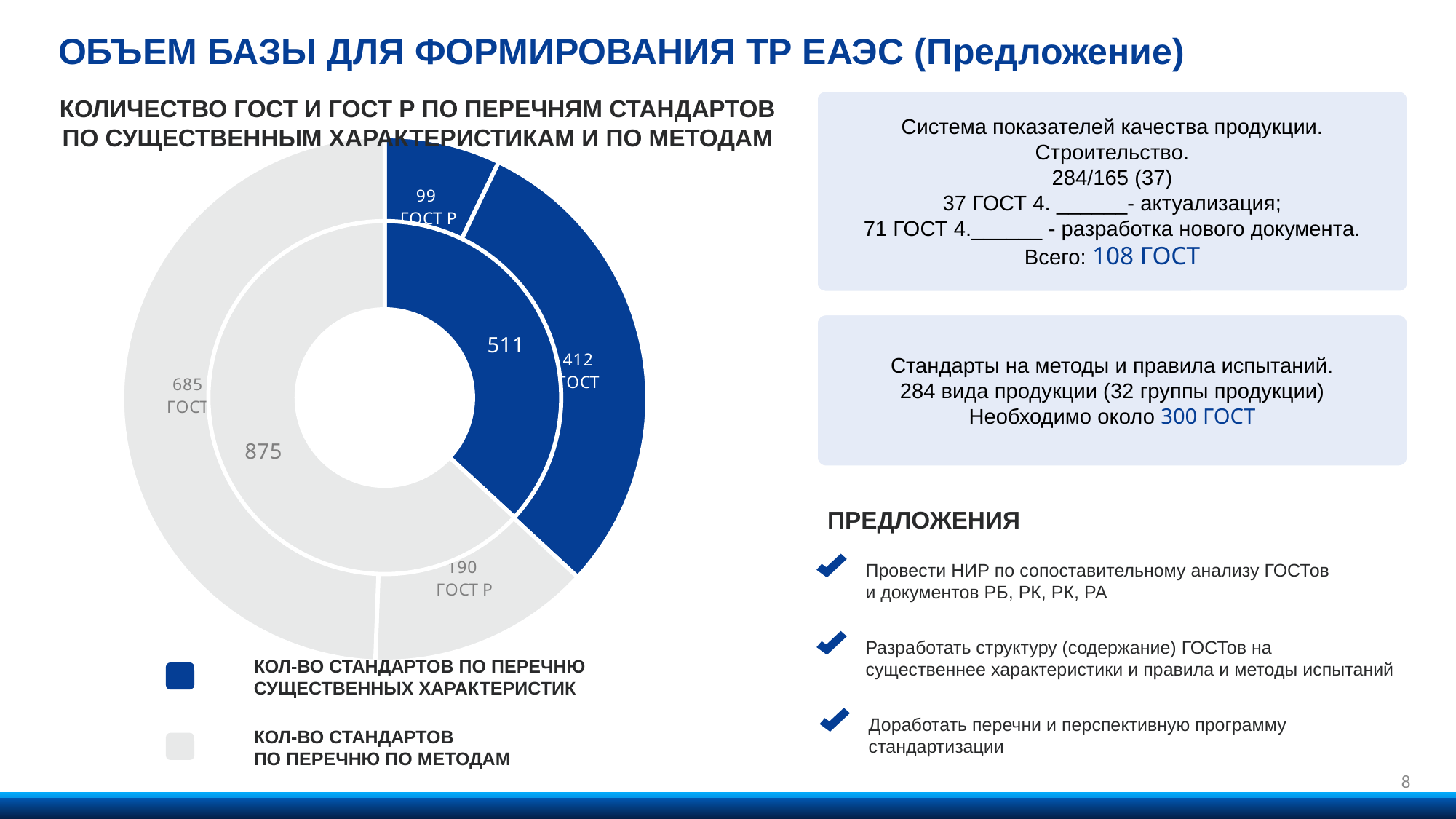
What is the value of the blue segment in the inner ring of the doughnut chart? 511 What is the total of the two inner-ring values, 511 and 875? 1386 What is the value of the blue ГОСТ segment in the outer ring? 412 What is the value of the blue ГОСТ Р segment in the outer ring? 99 What is the value of the grey segment in the inner ring of the doughnut chart? 875 Which inner-ring segment is larger: the blue one (511) or the grey one (875)? the grey one (875) How many entries does the chart legend list? 2 What type of chart is shown on the slide? doughnut chart What is the value of the grey ГОСТ segment in the outer ring? 685 What is the difference between the blue ГОСТ value (412) and the blue ГОСТ Р value (99) in the outer ring? 313 Which legend entry is shown in blue? КОЛ-ВО СТАНДАРТОВ ПО ПЕРЕЧНЮ СУЩЕСТВЕННЫХ ХАРАКТЕРИСТИК What is the difference between the inner-ring values 875 and 511? 364